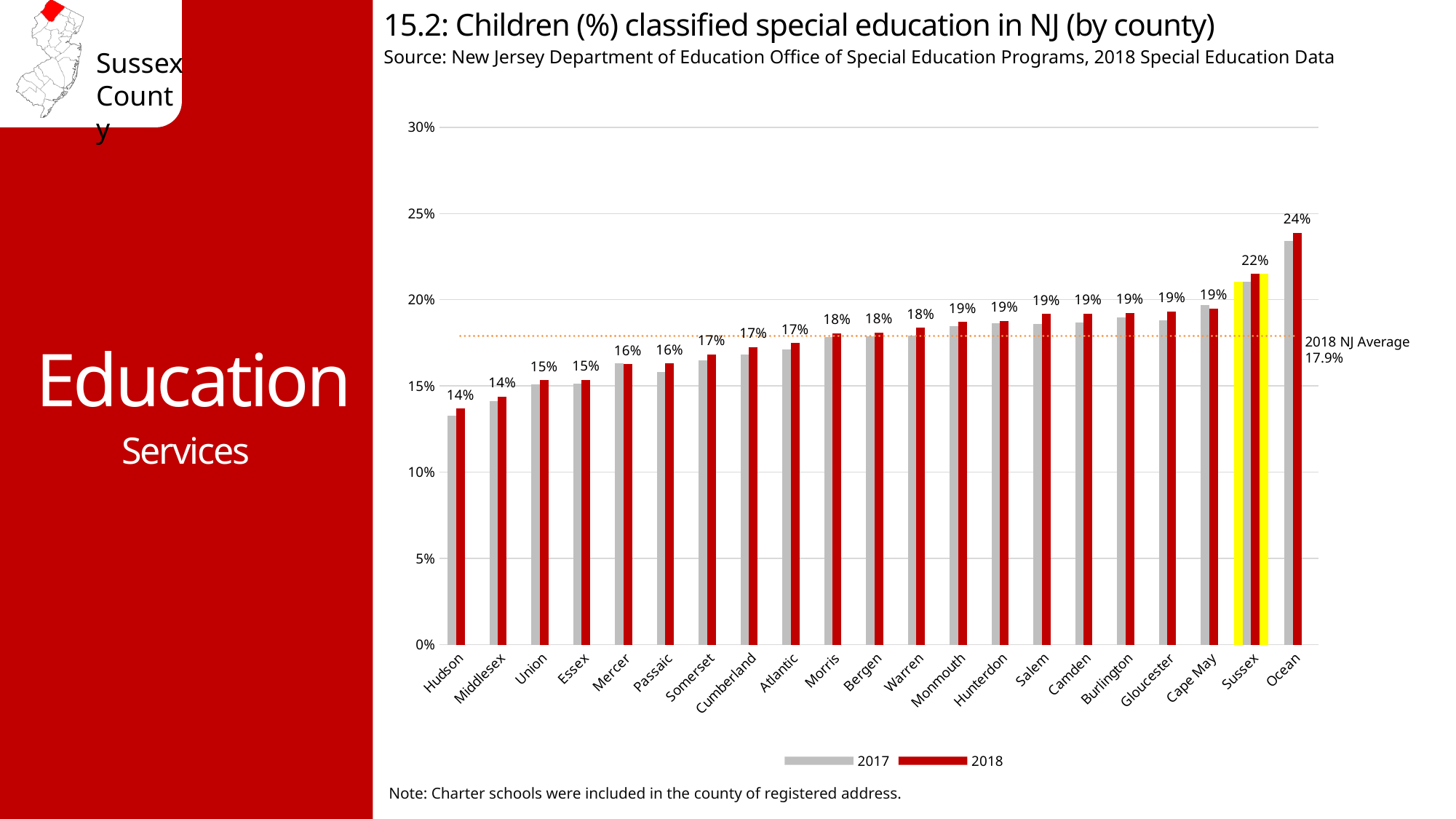
How many counties are shown on the x axis? 21 Is the 2017 value for Hudson greater or less than 15%? less Which county has the highest 2018 value? Ocean What is the 2018 NJ average shown by the dotted line? 17.9% What kind of chart is shown? bar chart What is the 2018 value for Hudson county? 14% Is the 2017 value for Ocean greater or less than 20%? greater Which has the larger 2018 value, Sussex or Cape May? Sussex What is the 2018 value for Ocean county? 24% How many series does the legend list? 2 What is the 2018 value for Sussex county? 22% What is the difference between the 2018 values for Ocean and Hudson? 10 percentage points